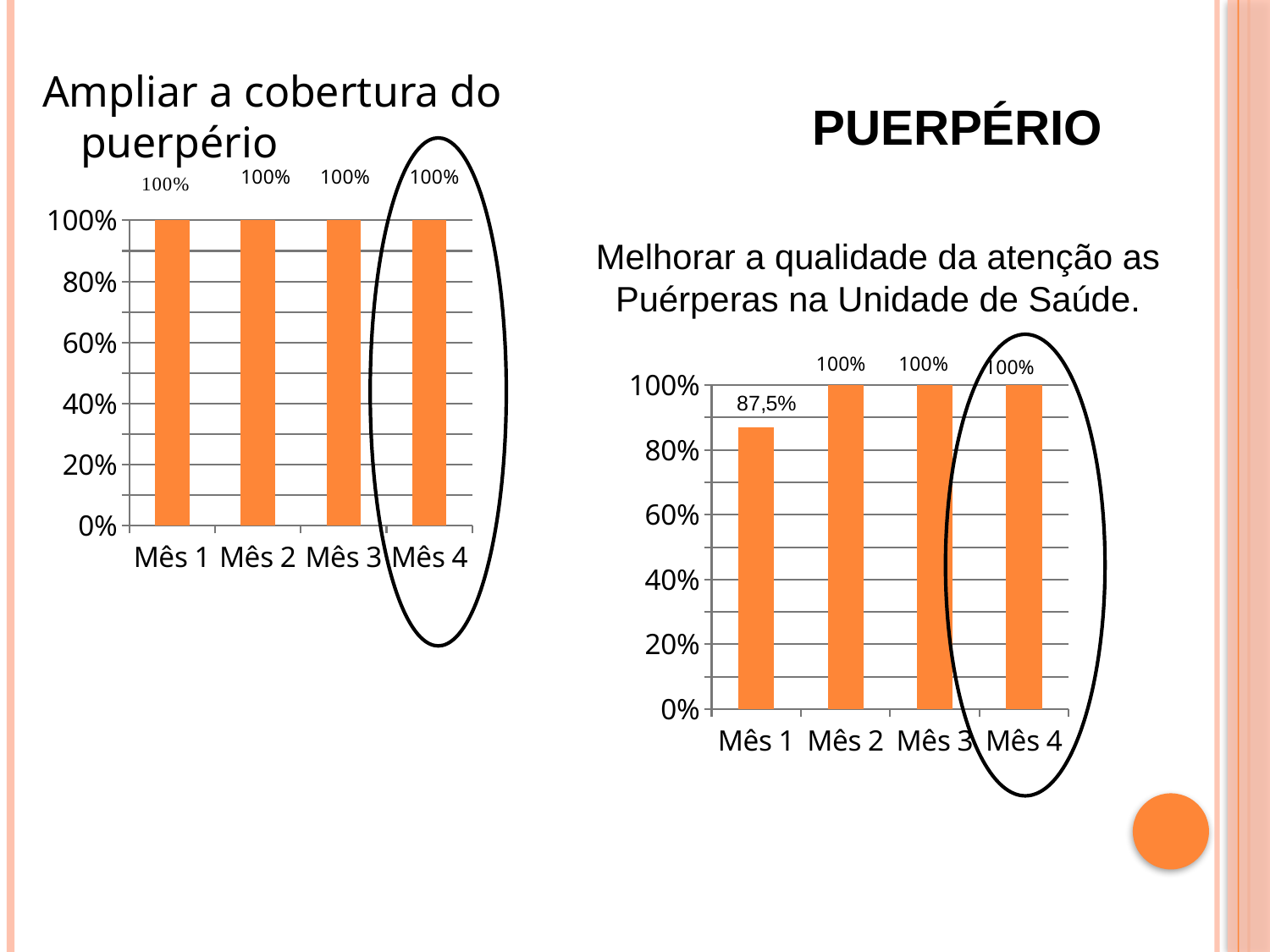
In the left chart (Ampliar a cobertura do puerpério), what is the value for Mês 1? 100% In the right chart (Melhorar a qualidade da atenção as Puérperas), which is larger, the value for Mês 1 or the value for Mês 3? Mês 3 What colour are the bars in both charts on the slide? orange In the right chart (Melhorar a qualidade da atenção as Puérperas), what is the difference between the values for Mês 2 and Mês 1? 12,5% What kind of chart is the left chart (Ampliar a cobertura do puerpério)? bar chart In the right chart (Melhorar a qualidade da atenção as Puérperas), do the values rise or fall from Mês 1 to Mês 2? rise In the right chart (Melhorar a qualidade da atenção as Puérperas), which month has the lowest value? Mês 1 In the right chart (Melhorar a qualidade da atenção as Puérperas), what is the value for Mês 1? 87,5% In the left chart (Ampliar a cobertura do puerpério), what is the value for Mês 4? 100% In the right chart (Melhorar a qualidade da atenção as Puérperas), is the value for Mês 1 greater or less than 80%? greater In the right chart (Melhorar a qualidade da atenção as Puérperas), what is the value for Mês 2? 100% In the left chart (Ampliar a cobertura do puerpério), how many months are plotted? 4